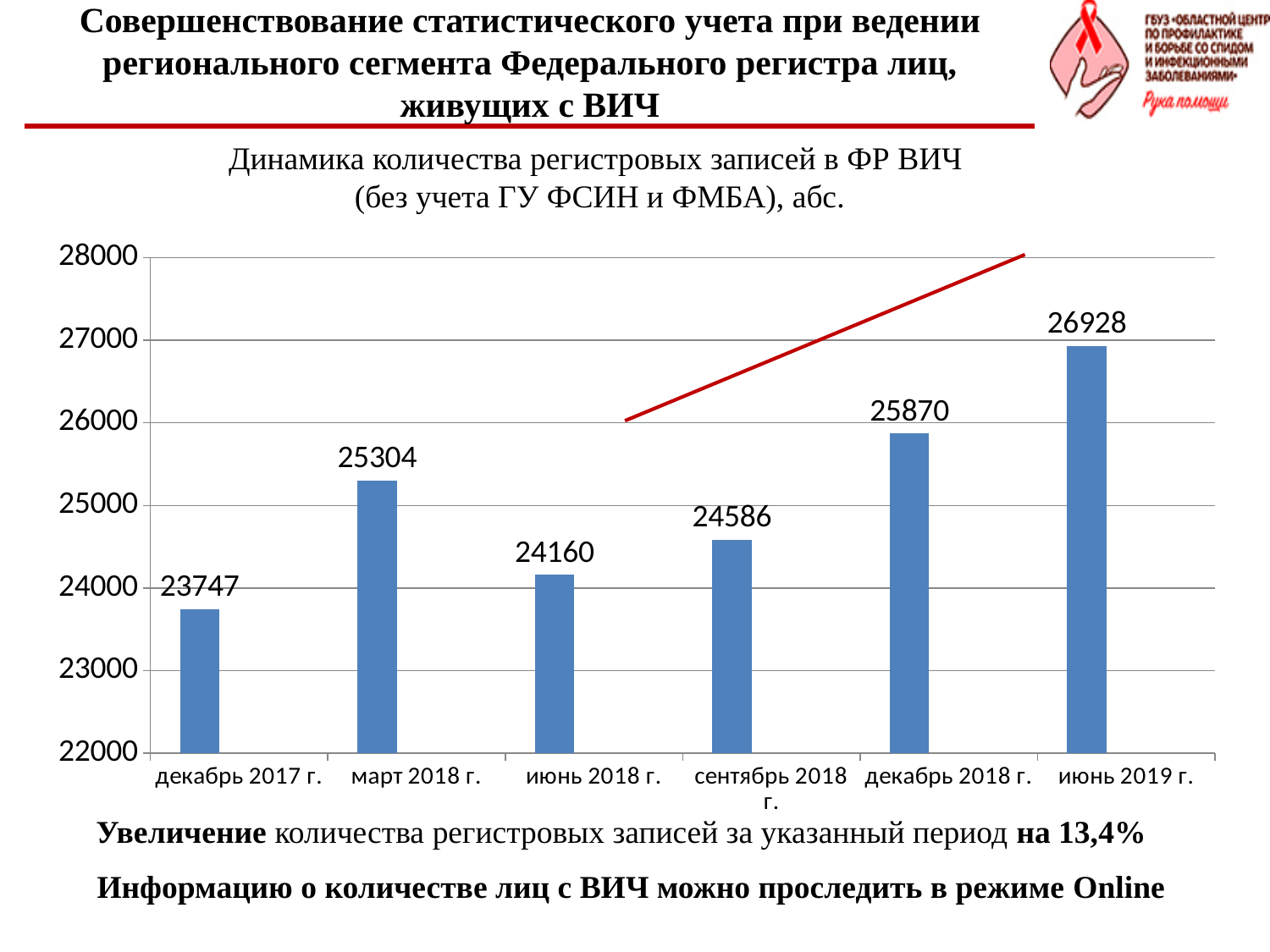
Which is larger, the value for март 2018 г. or the value for сентябрь 2018 г.? март 2018 г. Which category has the lowest value? декабрь 2017 г. What is the title of the chart? Динамика количества регистровых записей в ФР ВИЧ (без учета ГУ ФСИН и ФМБА), абс. What is the value for июнь 2019 г.? 26928 What is the difference between the values for март 2018 г. and июнь 2018 г.? 1144 Which category has the highest value? июнь 2019 г. What is the value for декабрь 2017 г.? 23747 What is the difference between the values for июнь 2019 г. and декабрь 2018 г.? 1058 What kind of chart is shown on the slide? bar chart What is the value for сентябрь 2018 г.? 24586 How many categories are shown on the x axis? 6 Is the value for декабрь 2018 г. greater or less than 26000? less